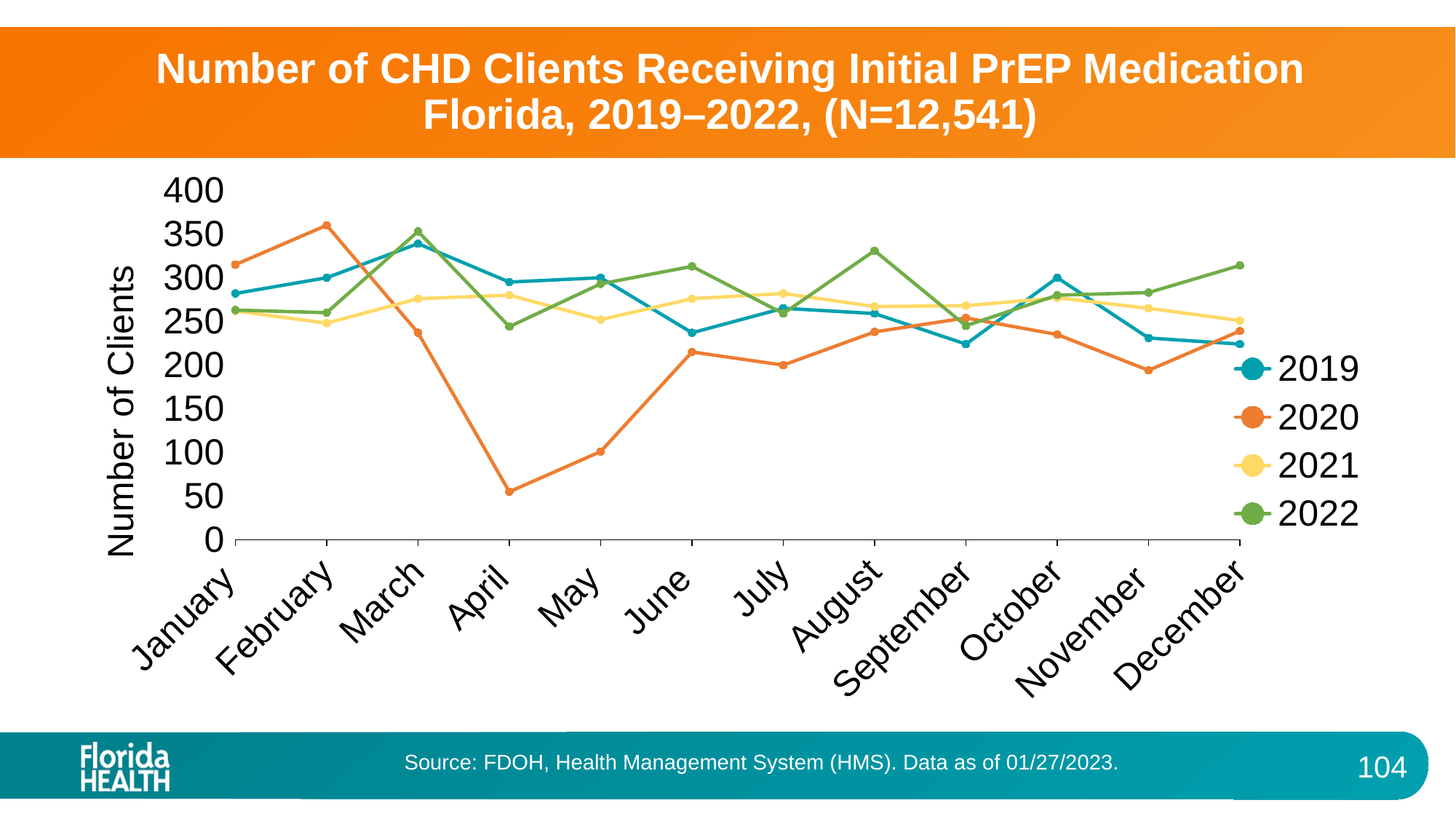
What kind of chart is shown on the slide? line chart Is the value for 2020 in April greater or less than 100? less Is the value for 2019 in March greater or less than 300? greater In April, which series has the larger value, 2019 or 2020? 2019 In which month does the 2020 series reach its lowest value? April Is the value for 2020 in February greater or less than 350? greater In March, which series has the larger value, 2021 or 2022? 2022 How many months are plotted along the x axis? 12 Does the 2020 series rise or fall from February to April? fall What is the label on the y axis? Number of Clients In which month does the 2020 series reach its highest value? February How many series does the legend list? 4